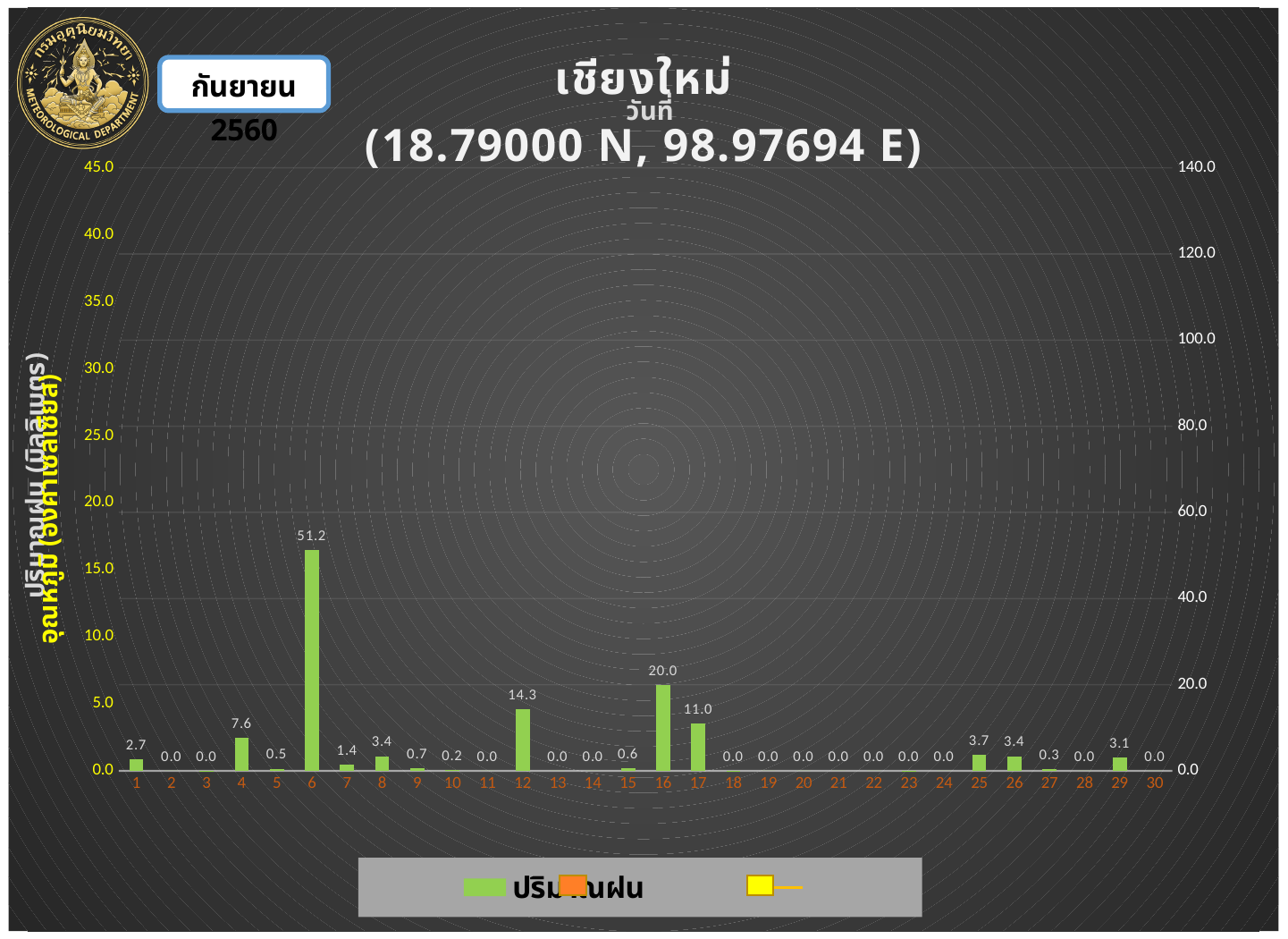
Which has the larger rainfall value, day 1 or day 8? day 8 What is the rainfall value shown for day 25? 3.7 How many days are shown on the x axis? 30 What is the rainfall value shown for day 6? 51.2 What month and year are shown in the box at the top left of the slide? กันยายน 2560 What kind of chart is shown on the slide? bar chart What is the difference between the rainfall values for day 6 and day 12? 36.9 Which has the larger rainfall value, day 4 or day 17? day 17 What is the rainfall value shown for day 12? 14.3 What is the difference between the rainfall values for day 16 and day 17? 9.0 Which day has the highest rainfall value? 6 What is the rainfall value shown for day 16? 20.0